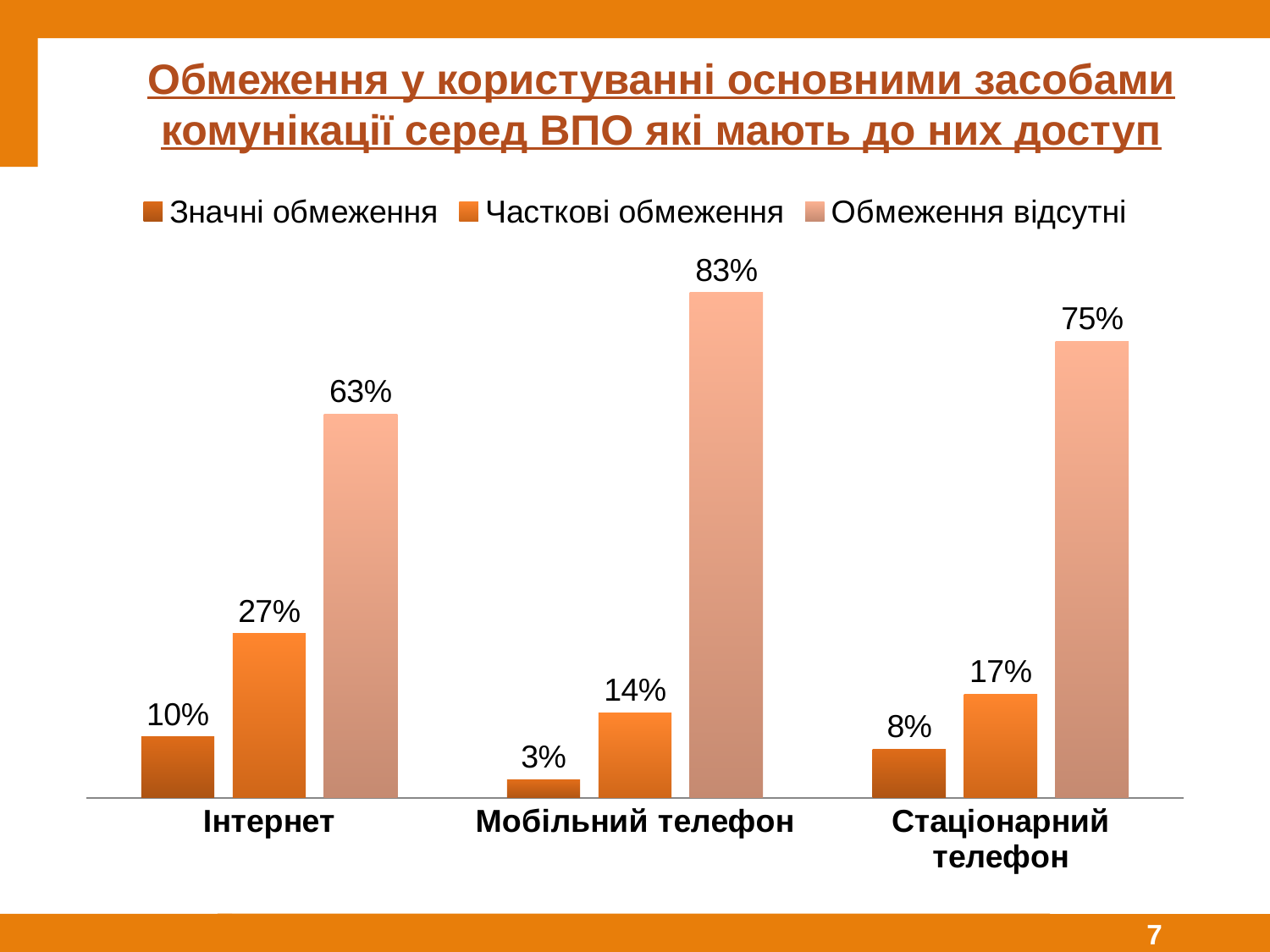
What is the difference between "Часткові обмеження" and "Значні обмеження" for "Мобільний телефон"? 11% Which is larger: "Часткові обмеження" for "Інтернет" or for "Стаціонарний телефон"? Інтернет How many categories are shown on the x axis? 3 What kind of chart is shown on the slide? Bar chart Which category has the lowest value for "Значні обмеження"? Мобільний телефон What is the difference between the "Обмеження відсутні" values for "Мобільний телефон" and "Інтернет"? 20% Which category has the highest value for "Обмеження відсутні"? Мобільний телефон Which legend entry is shown in the lightest colour? Обмеження відсутні How many series does the legend list? 3 What is the value for "Часткові обмеження" for "Стаціонарний телефон"? 17% What is the value for "Значні обмеження" for "Інтернет"? 10% What is the value for "Обмеження відсутні" for "Мобільний телефон"? 83%